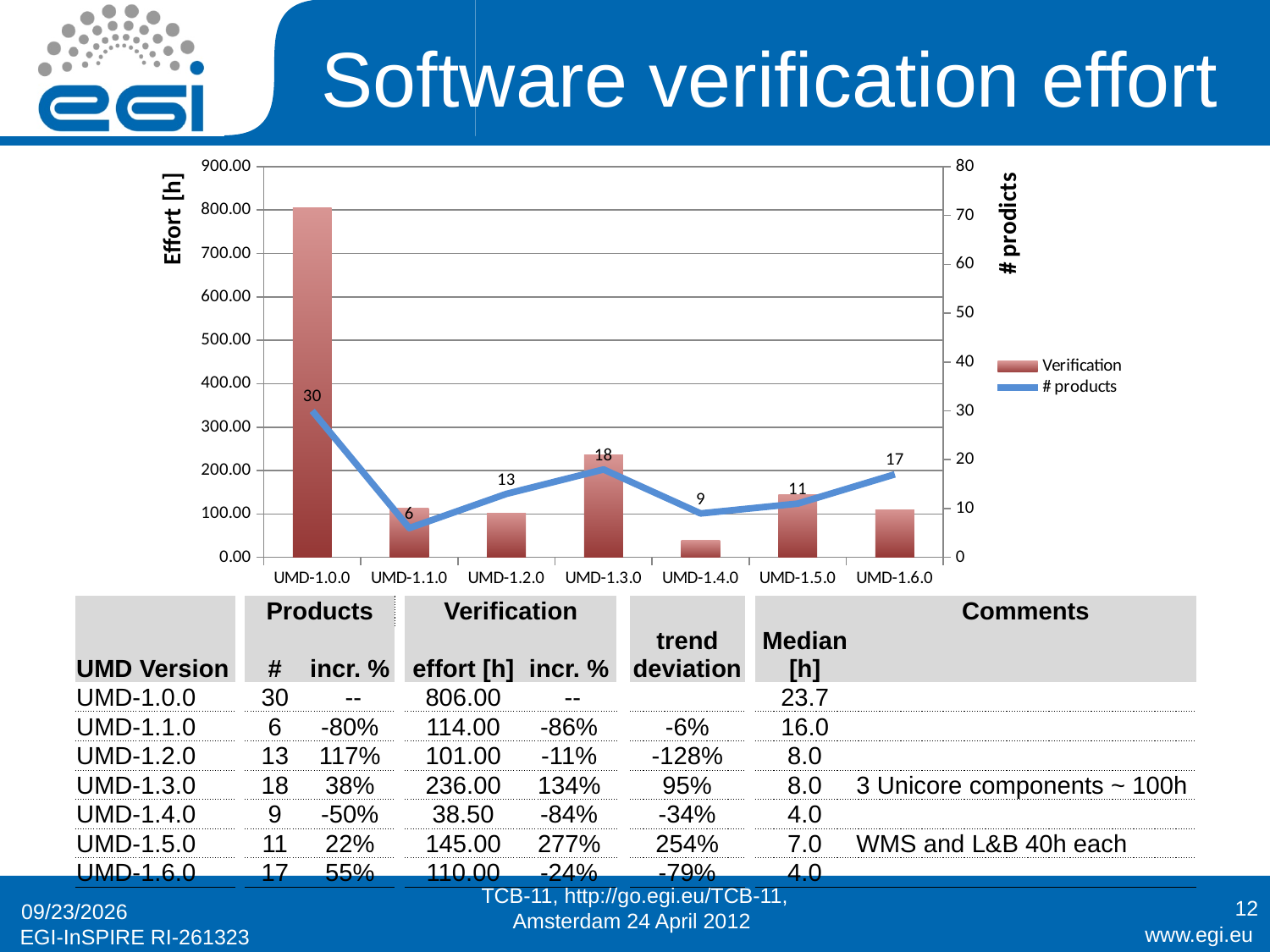
Which UMD version has the highest number of products? UMD-1.0.0 How many UMD versions are shown on the x axis? 7 How many series does the legend list? 2 Which has more products, UMD-1.2.0 or UMD-1.4.0? UMD-1.2.0 What is the number of products for UMD-1.3.0? 18 Is the Verification effort for UMD-1.0.0 greater or less than 700? greater Which UMD version has the lowest number of products? UMD-1.1.0 What is the label of the left vertical axis? Effort [h] Is the Verification effort for UMD-1.4.0 greater or less than 100? less Which UMD version has the lowest Verification effort bar? UMD-1.4.0 What is the number of products for UMD-1.0.0? 30 What is the difference in number of products between UMD-1.6.0 and UMD-1.5.0? 6